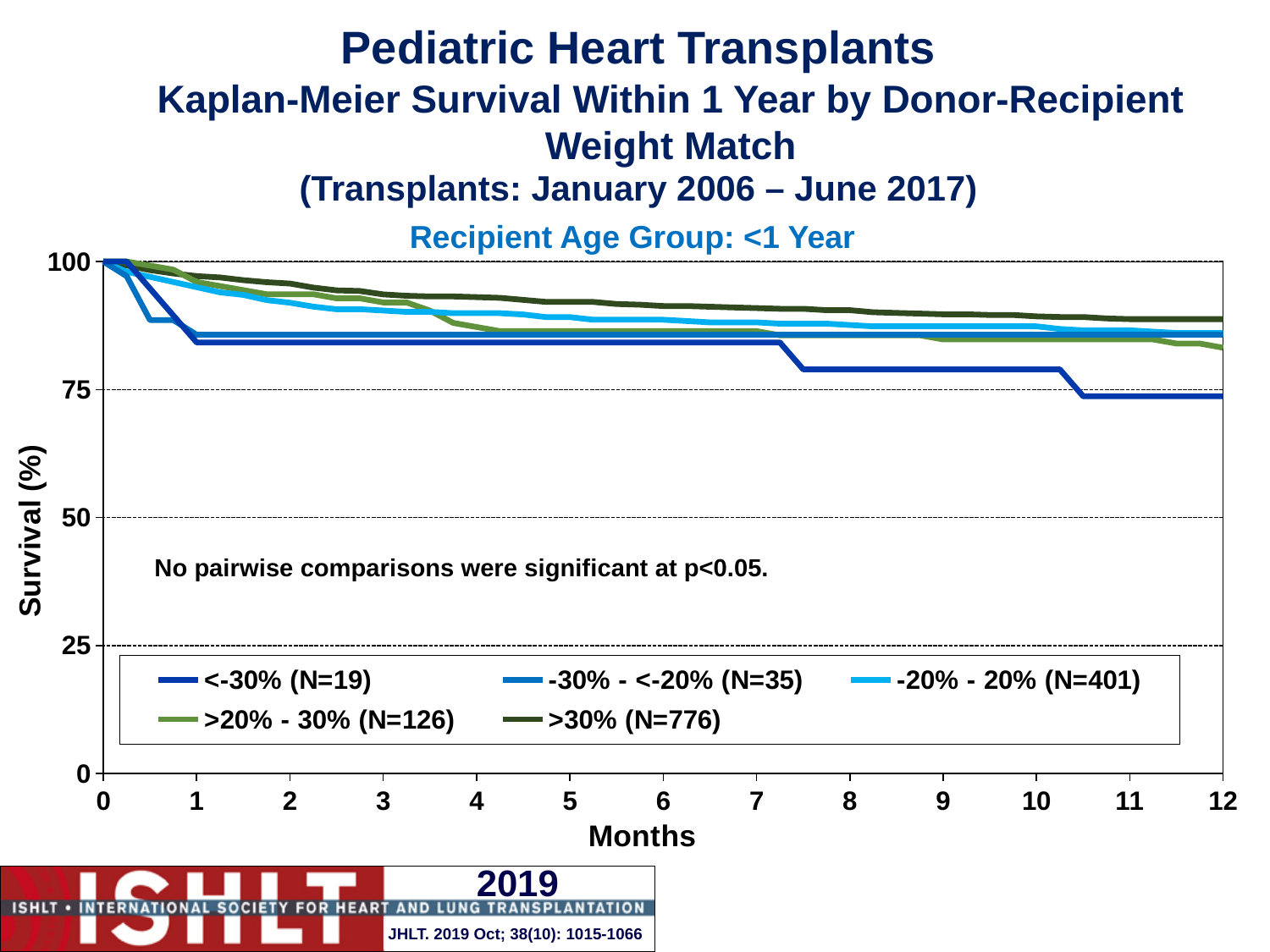
How many series does the legend list? 5 What is the N for the >30% group shown in the legend? 776 Is the survival for the <-30% (N=19) group at 12 months greater or less than 75? less Is the survival for the -20% - 20% (N=401) group at 6 months greater or less than 75? greater Which recipient age group does the chart cover? <1 Year Which weight-match group has the highest survival at 12 months? >30% (N=776) At 12 months, which group has higher survival: <-30% (N=19) or >30% (N=776)? >30% (N=776) What kind of chart is shown on the slide? line chart Do the survival curves rise or fall as months increase? fall Is the survival for the >30% (N=776) group at 12 months greater or less than 75? greater Which weight-match group has the lowest survival at 12 months? <-30% (N=19) At 3 months, which group has higher survival: <-30% (N=19) or >30% (N=776)? >30% (N=776)